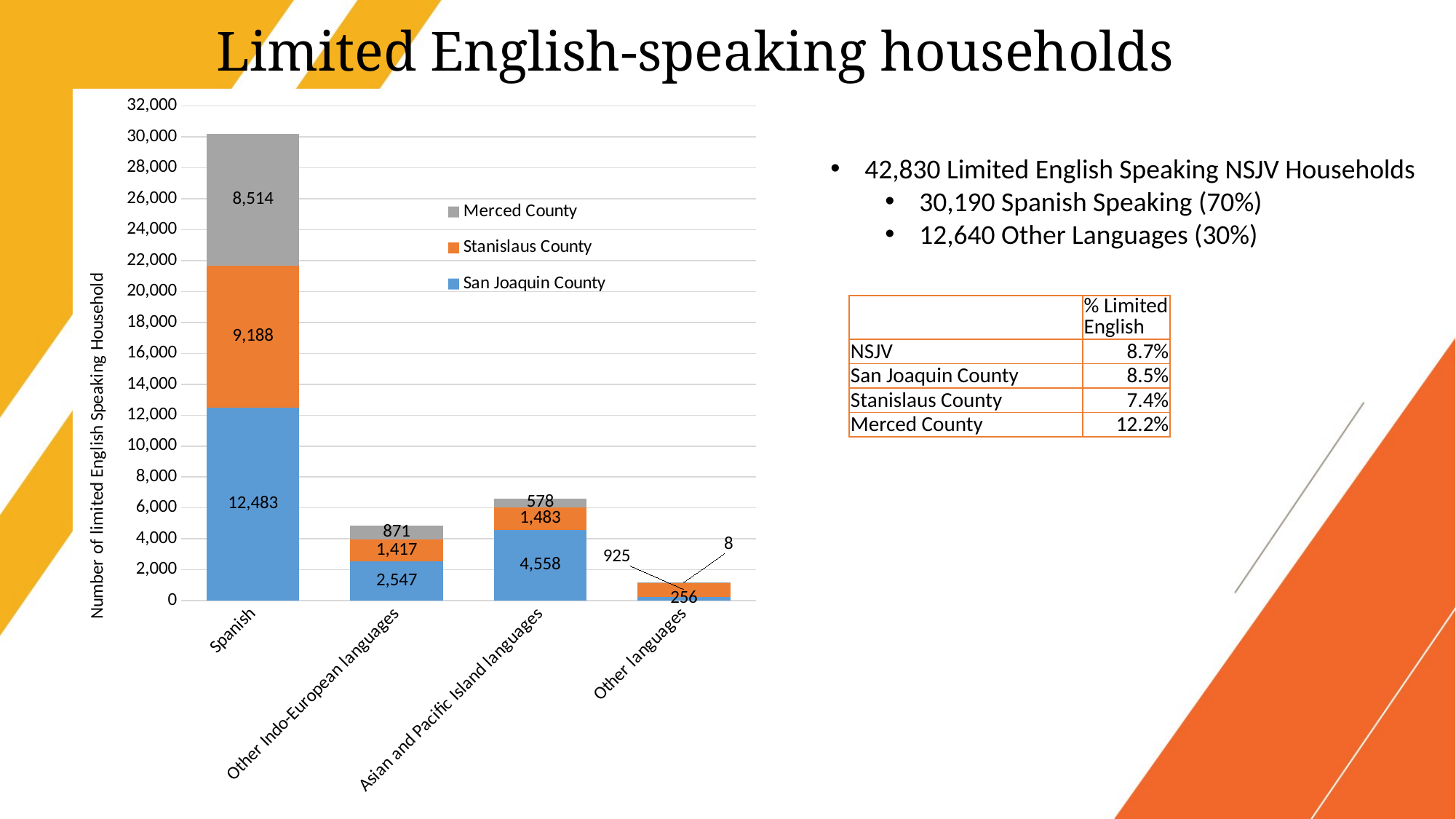
Which language category has the tallest stacked bar in the chart? Spanish How many series does the chart legend list? 3 What is the Merced County value for Spanish in the chart? 8,514 What is the total of the stacked bar for Other Indo-European languages? 4,835 What is the difference between the San Joaquin County values for Spanish and Asian and Pacific Island languages? 7,925 How many language categories are shown on the x axis of the chart? 4 What type of chart is shown on the slide? stacked bar chart What is the San Joaquin County value for Spanish in the chart? 12,483 Is the total stacked bar for Spanish greater or less than 28,000? greater What is the Merced County value for Other Indo-European languages in the chart? 871 What is the Stanislaus County value for Asian and Pacific Island languages in the chart? 1,483 Which language category has the shortest stacked bar in the chart? Other languages